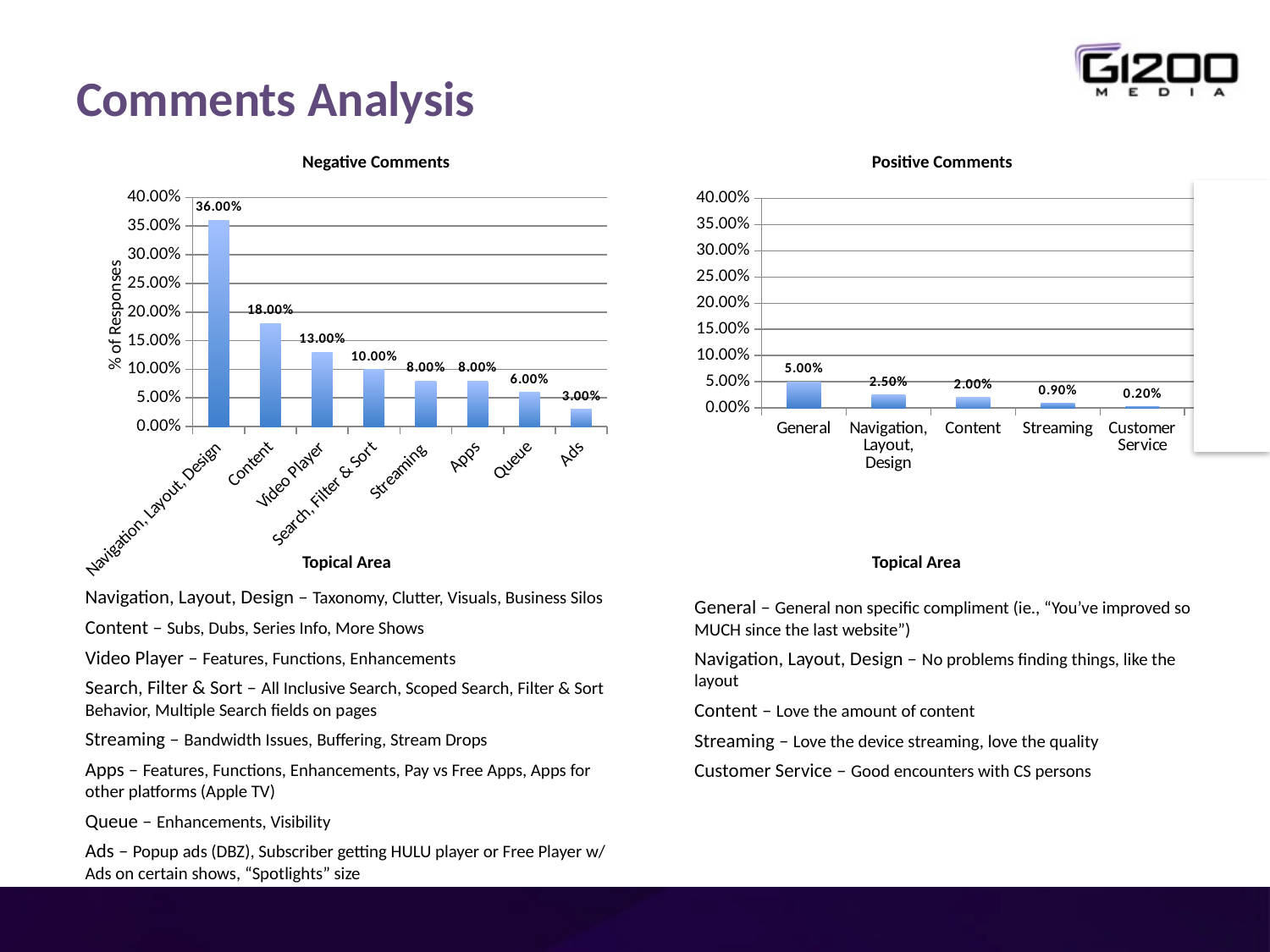
In the Negative Comments chart, what is the value for Content? 18.00% In the Negative Comments chart, what is the difference between the values for Navigation, Layout, Design and Content? 18.00% In the Negative Comments chart, which topical area has the lowest percentage of responses? Ads What is the x-axis title of the Negative Comments chart? Topical Area In the Negative Comments chart, what is the value for Queue? 6.00% In the Positive Comments chart, which is larger, the value for Content or the value for Streaming? Content In the Positive Comments chart, what is the value for General? 5.00% In the Negative Comments chart, how many topical areas are shown? 8 What kind of chart is the Positive Comments chart? Bar chart In the Positive Comments chart, which topical area has the lowest value? Customer Service In the Positive Comments chart, how many topical areas are shown? 5 In the Negative Comments chart, which topical area has the highest percentage of responses? Navigation, Layout, Design